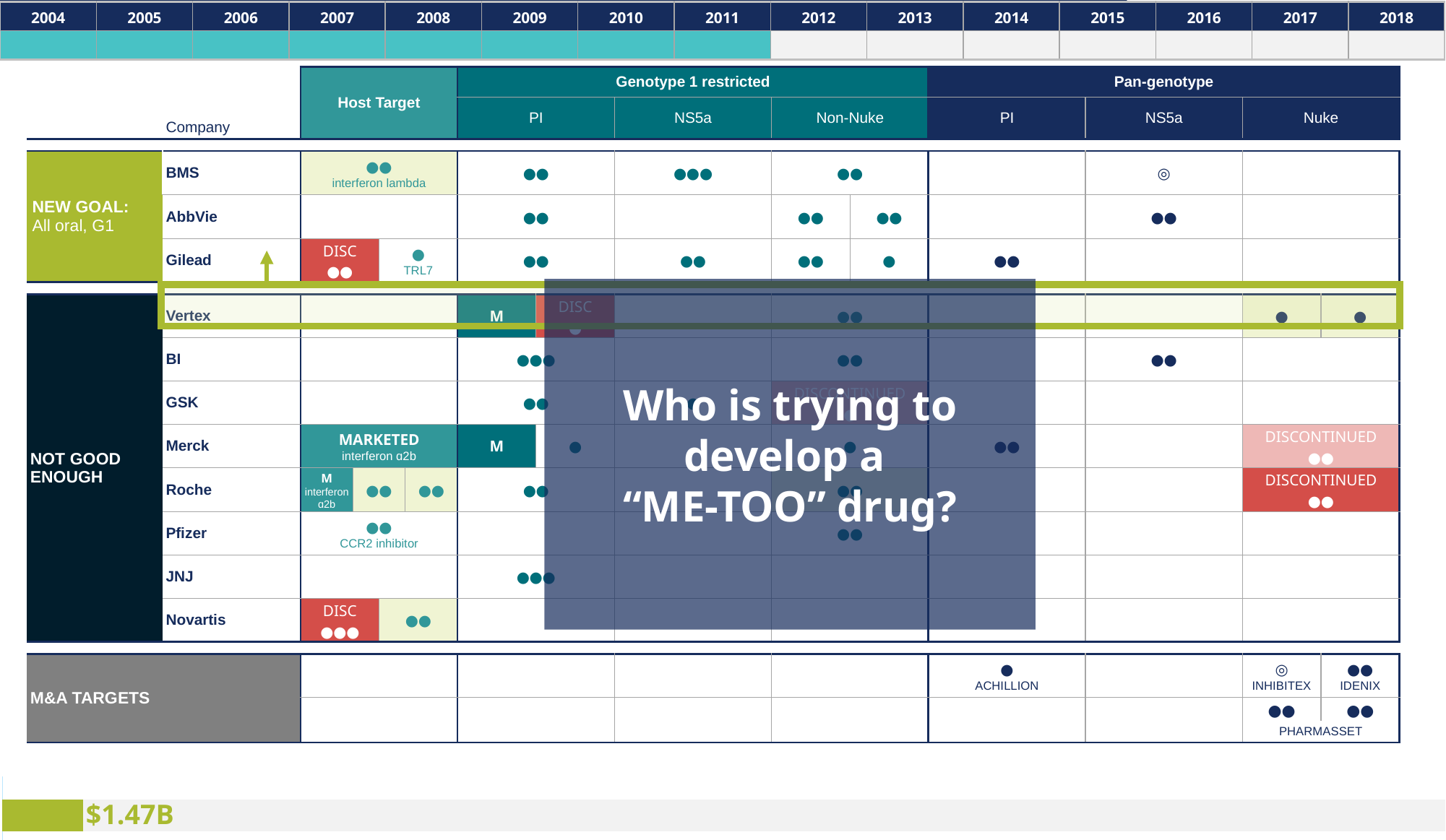
What is the last year shown on the timeline across the top of the slide? 2018 What is the first year shown on the timeline across the top of the slide? 2004 How many years are shown on the timeline across the top of the slide? 15 Which company's Host Target cell is labeled 'CCR2 inhibitor'? Pfizer How many dots are shown for JNJ in the Genotype 1 restricted PI column? 3 Which M&A target is listed under the Pan-genotype PI column? ACHILLION How many companies are listed in the Company column of the table? 11 Which company has 'MARKETED interferon α2b' in its Host Target cell? Merck Which companies are grouped under the 'NEW GOAL: All oral, G1' label? BMS, AbbVie, Gilead What are the three top-level column group headers of the table? Host Target, Genotype 1 restricted, Pan-genotype What value is printed on the green bar at the bottom of the slide? $1.47B